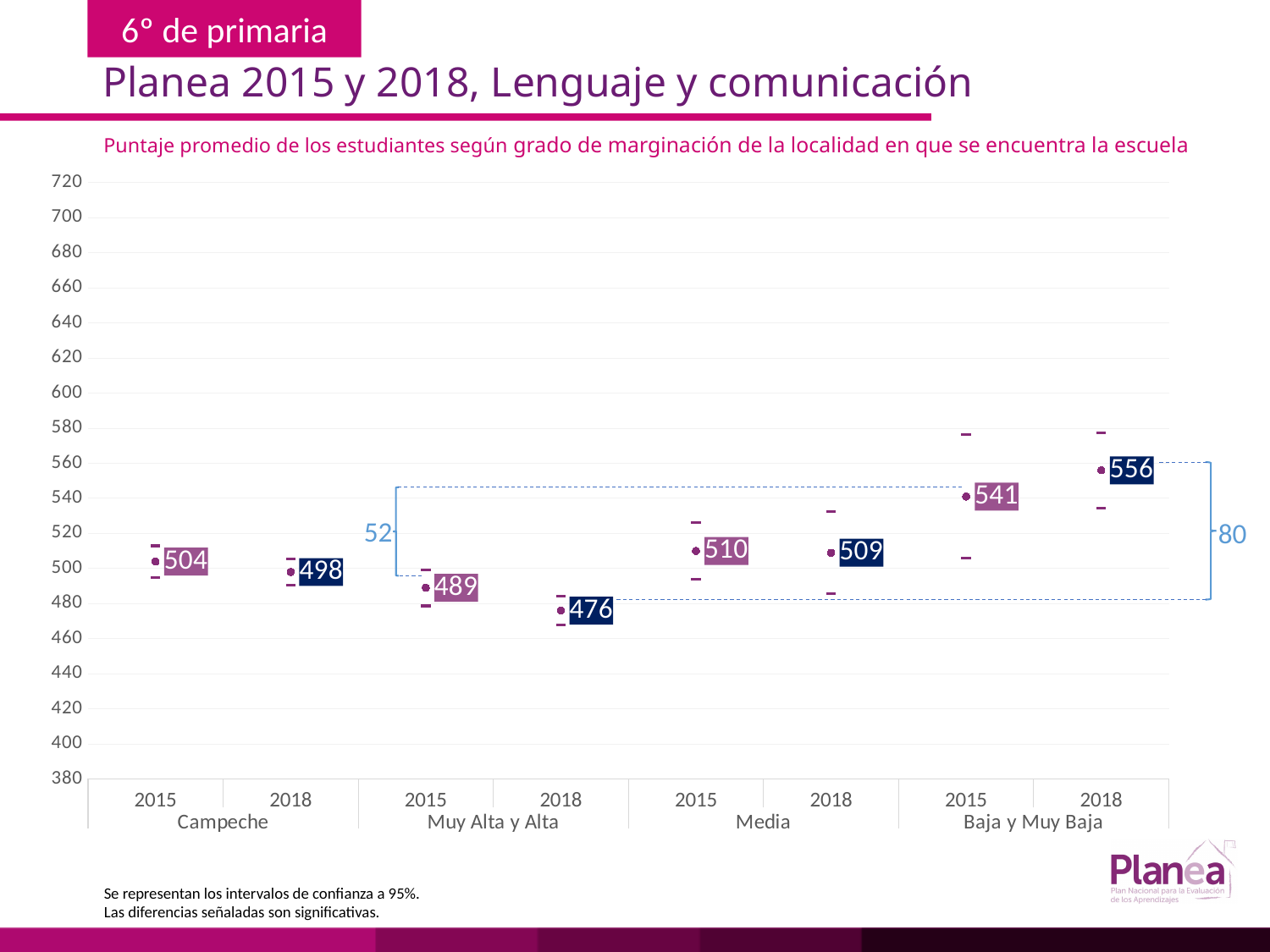
Which is larger, the 2015 score for Campeche or the 2018 score for Campeche? 2015 (504) What is the 2015 average score for Campeche? 504 Is the 2015 score for the Baja y Muy Baja group greater or less than 520? greater What is the 2018 average score for the Muy Alta y Alta marginación group? 476 What is the 2015 average score for the Media group? 510 Which group and year has the highest average score? Baja y Muy Baja, 2018 Did the average score for the Baja y Muy Baja group rise or fall from 2015 to 2018? rise What is the 2018 average score for the Baja y Muy Baja group? 556 What is the difference between the 2015 scores of the Baja y Muy Baja group and the Muy Alta y Alta group? 52 What is the difference between the 2018 scores of the Baja y Muy Baja group and the Muy Alta y Alta group? 80 Which group and year has the lowest average score? Muy Alta y Alta, 2018